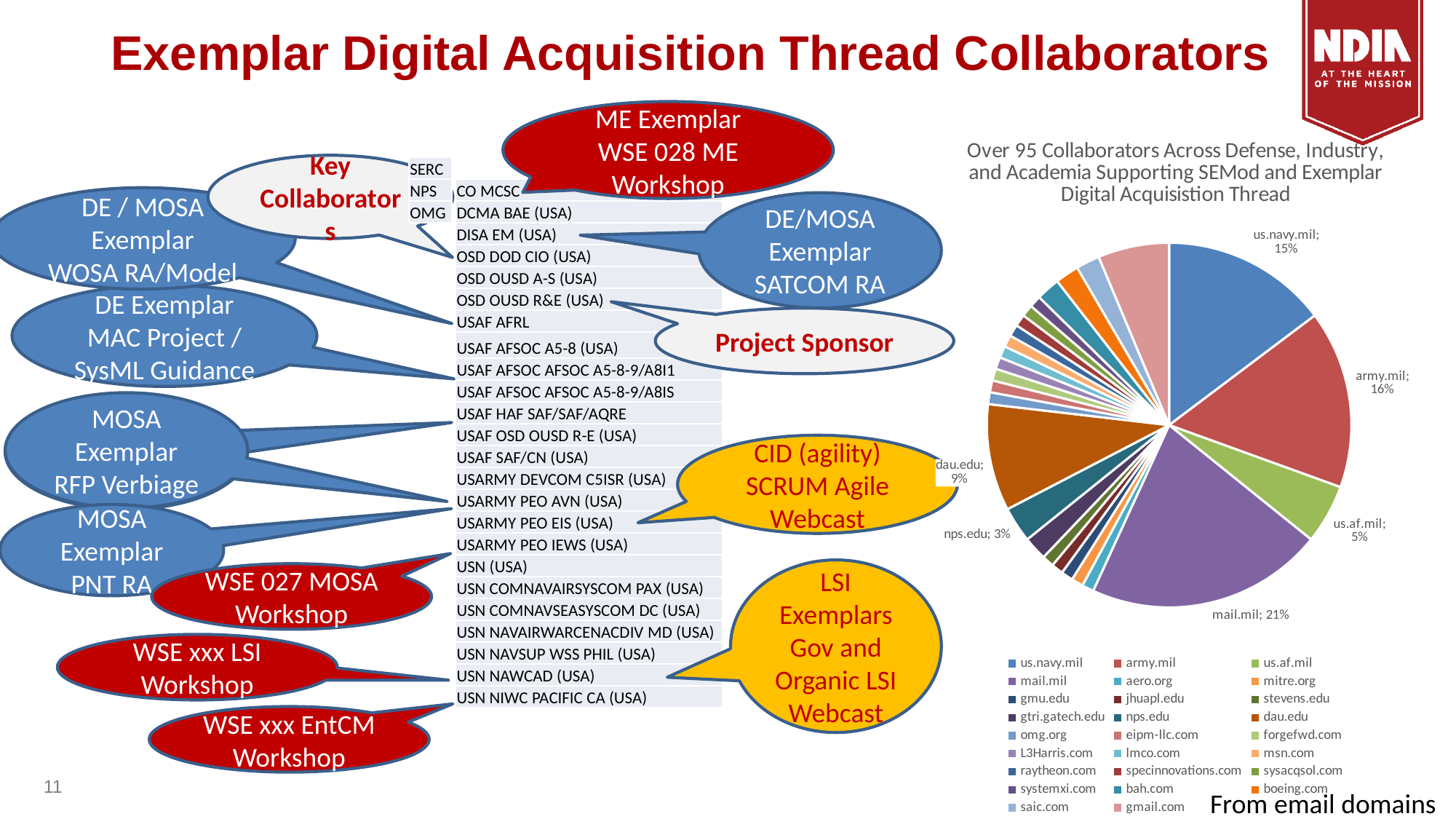
Which has a larger share, army.mil or us.navy.mil? army.mil Which email domain has the largest slice of the pie? mail.mil What percentage is shown for army.mil? 16% How many email domains are listed in the pie chart legend? 26 What percentage is shown for us.navy.mil? 15% What share of the pie does mail.mil account for? 21% What kind of chart is shown on the slide? pie chart What is the title of the pie chart? Over 95 Collaborators Across Defense, Industry, and Academia Supporting SEMod and Exemplar Digital Acquisistion Thread What is the difference in percentage points between mail.mil and army.mil? 5% What percentage is labeled for nps.edu? 3% What share of the pie does us.af.mil have? 5% What percentage is labeled for dau.edu? 9%